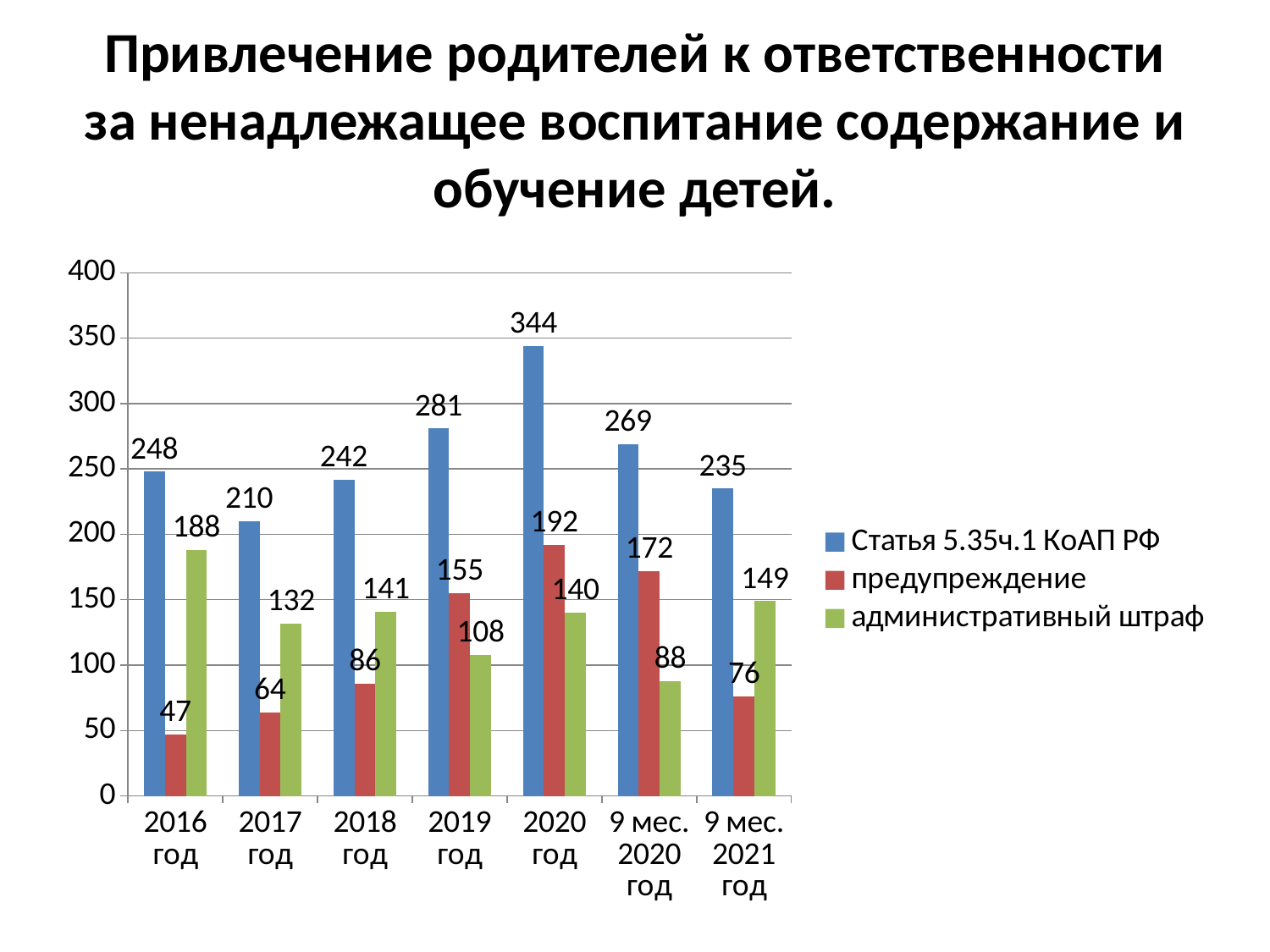
What is the value for предупреждение in 2016 год? 47 What kind of chart is shown on the slide? bar chart Which is larger in 2018 год: предупреждение or административный штраф? административный штраф What is the value for административный штраф in 9 мес. 2021 год? 149 How many series does the legend list? 3 Which category has the lowest value for предупреждение? 2016 год Which category has the highest value for Статья 5.35ч.1 КоАП РФ? 2020 год What is the value for Статья 5.35ч.1 КоАП РФ in 2020 год? 344 How many categories are shown on the x axis? 7 Which colour represents предупреждение in the legend? red Is the value for административный штраф in 2016 год greater or less than 150? greater What is the difference between Статья 5.35ч.1 КоАП РФ in 2020 год and in 2019 год? 63